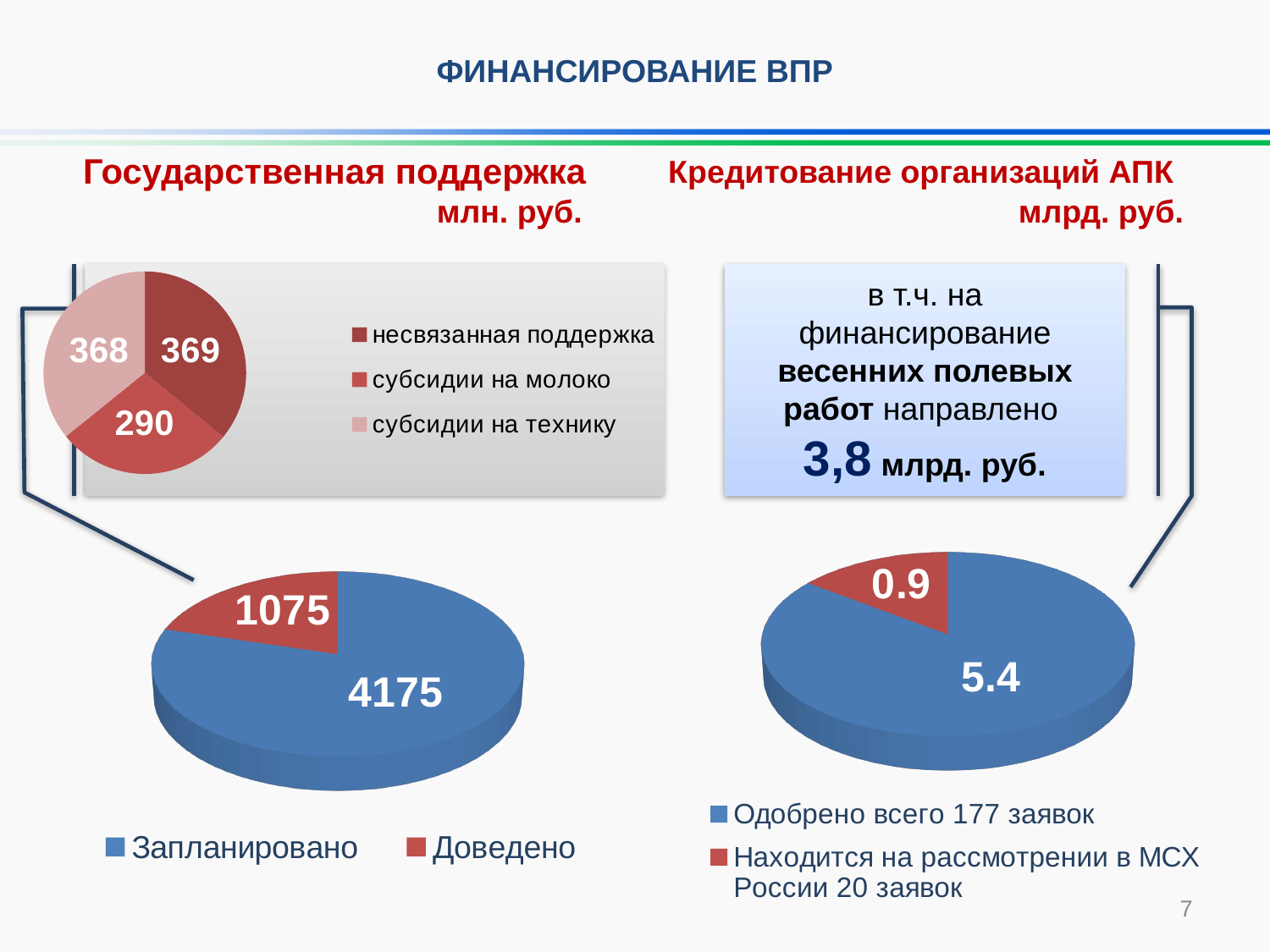
In the bottom-left pie chart, what is the value for Запланировано? 4175 What kind of chart is the bottom-right chart? pie chart In the top-left pie chart, what is the difference between несвязанная поддержка and субсидии на молоко? 79 In the bottom-left pie chart, what is the total of Запланировано and Доведено? 5250 In the top-left pie chart, which category has the smallest value? субсидии на молоко In the bottom-left pie chart, which is larger, Запланировано or Доведено? Запланировано In the top-left pie chart, what is the value for несвязанная поддержка? 369 In the bottom-right pie chart, what is the value for Одобрено всего 177 заявок? 5.4 In the bottom-left pie chart, what is the value for Доведено? 1075 In the top-left pie chart, what is the value for субсидии на молоко? 290 In the bottom-right pie chart, what is the difference between the two slices? 4.5 In the top-left pie chart, how many categories does the legend list? 3